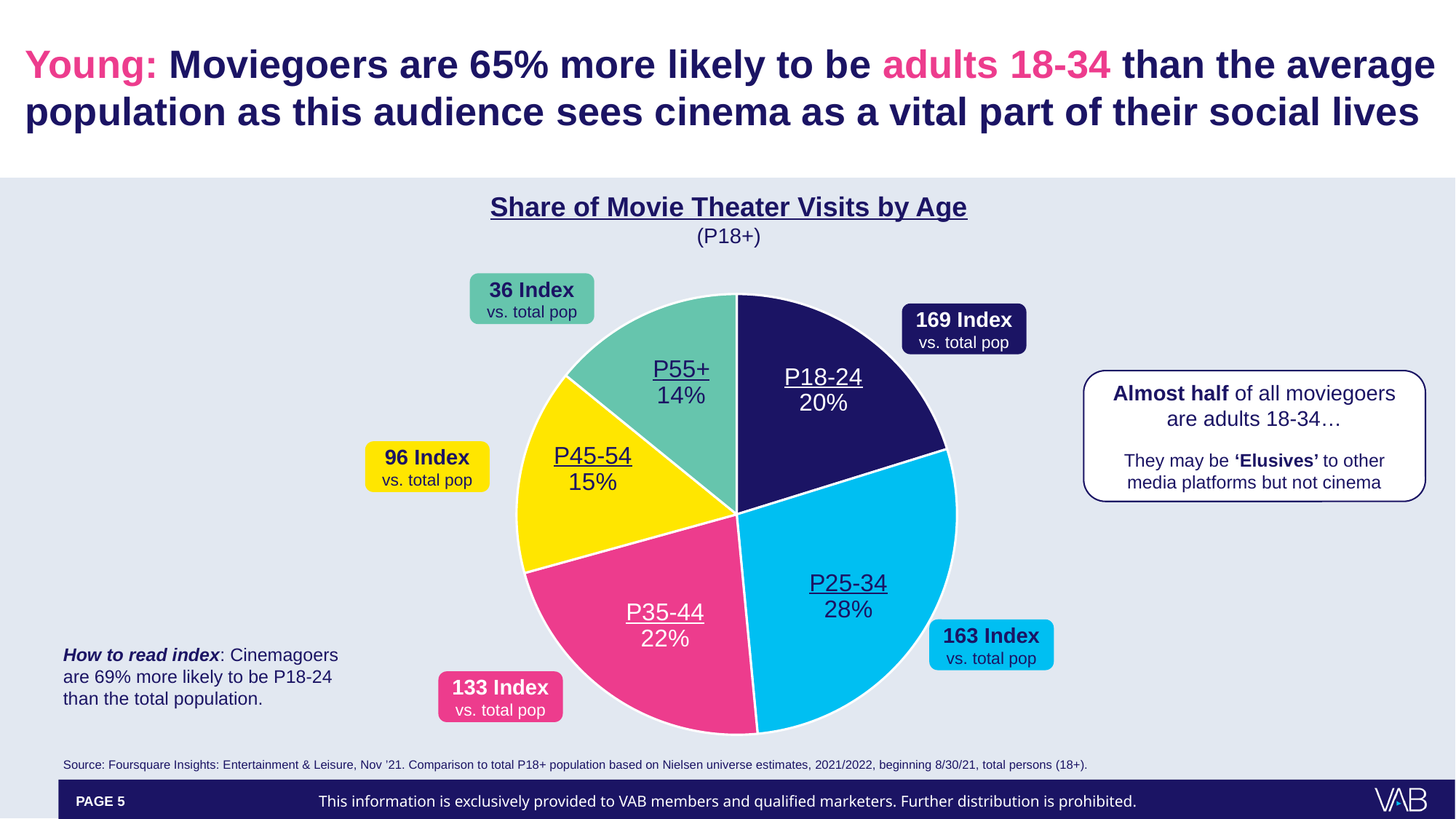
What index vs. total population is shown for P35-44? 133 Index What share of movie theater visits comes from P25-34? 28% What is the title of the pie chart? Share of Movie Theater Visits by Age What kind of chart is shown on the slide? Pie chart Which has a larger share of movie theater visits, P35-44 or P45-54? P35-44 How many age groups are shown in the pie chart? 5 What index vs. total population is shown for P55+? 36 Index Which age group has the smallest share of movie theater visits? P55+ What is the difference in share between P25-34 and P18-24? 8% What is the combined share of P18-24 and P25-34? 48% Which age group has the largest share of movie theater visits? P25-34 What share of movie theater visits comes from P55+? 14%